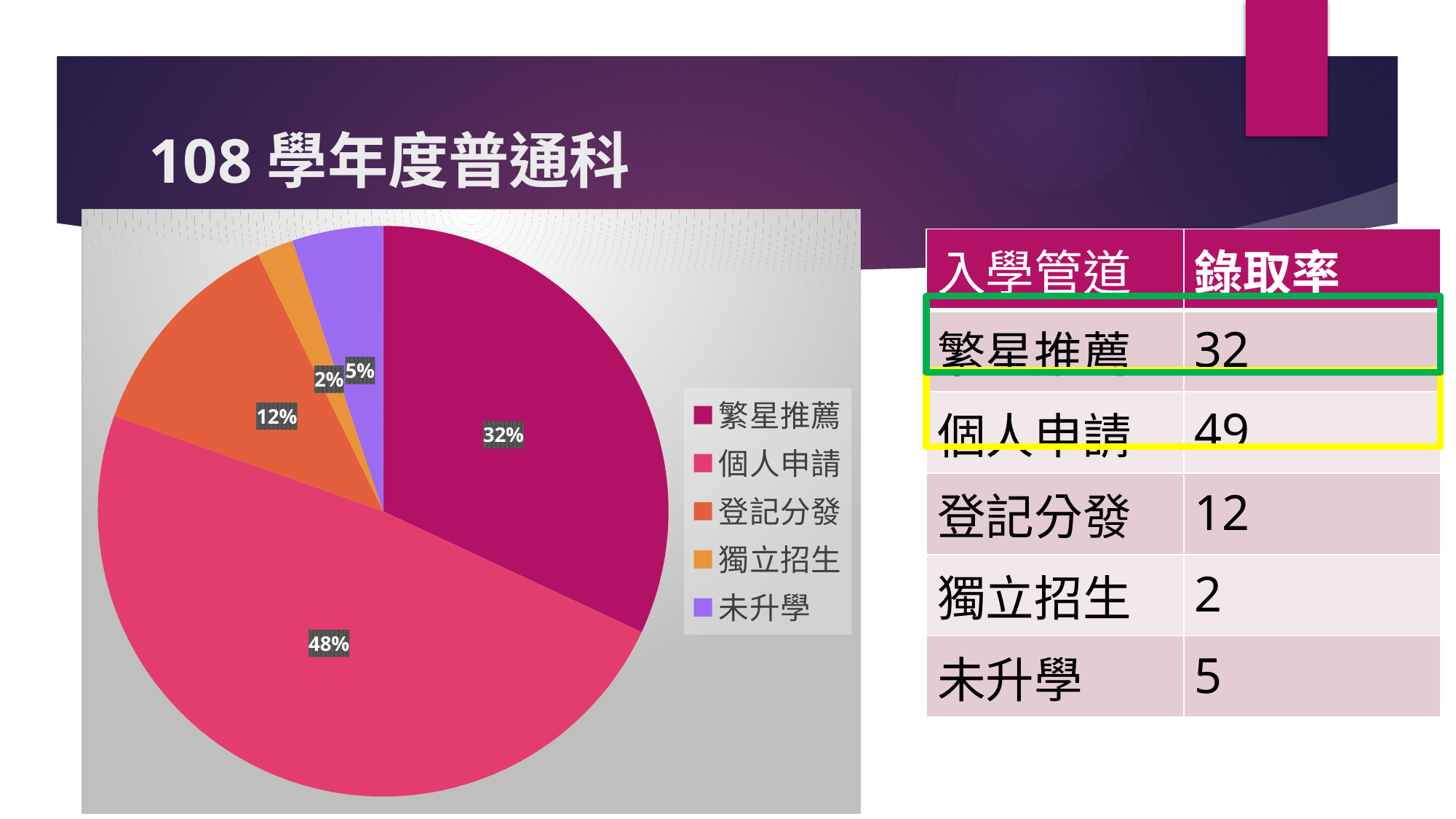
What percentage does the pie chart show for 獨立招生? 2% Which category has the largest slice in the pie chart? 個人申請 What percentage does the pie chart show for 登記分發? 12% What percentage does the pie chart show for 未升學? 5% Which category has the smallest slice in the pie chart? 獨立招生 What percentage does the pie chart show for 個人申請? 48% Which slice is larger in the pie chart, 登記分發 or 未升學? 登記分發 What is the title of the slide containing the pie chart? 108 學年度普通科 What type of chart is shown on the slide? pie chart How many slices does the pie chart have? 5 What is the difference in percentage points between the 個人申請 slice and the 繁星推薦 slice? 16 What percentage does the pie chart show for 繁星推薦? 32%